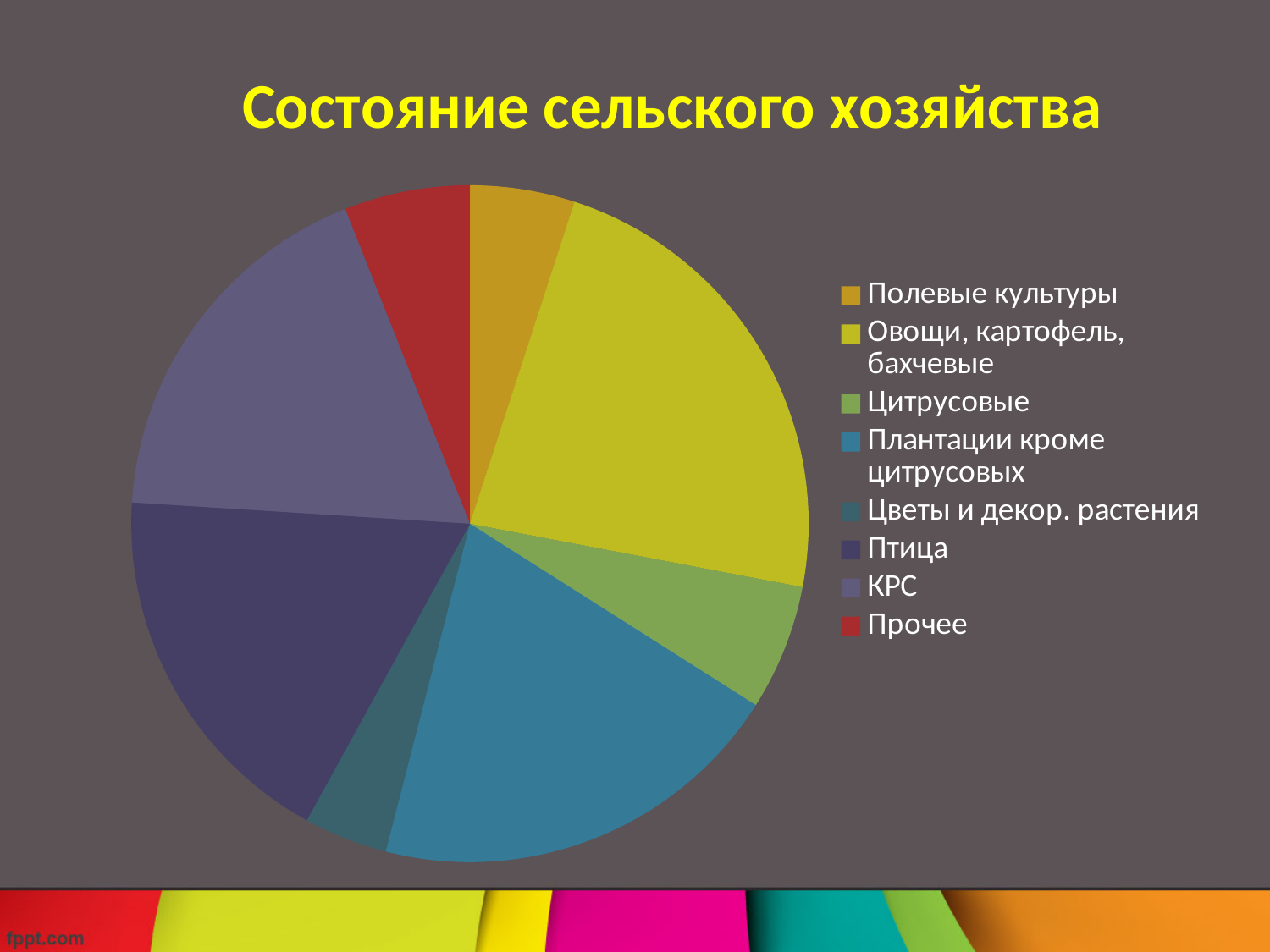
What is the title of the slide containing the pie chart? Состояние сельского хозяйства What kind of chart is shown on the slide? pie chart How many slices does the pie chart have? 8 Which legend entry is shown in red? Прочее Which slice is larger: Птица or Прочее? Птица Which slice is larger: Плантации кроме цитрусовых or Цветы и декор. растения? Плантации кроме цитрусовых Which slice is larger: КРС or Полевые культуры? КРС Which category has the largest slice in the pie chart? Овощи, картофель, бахчевые